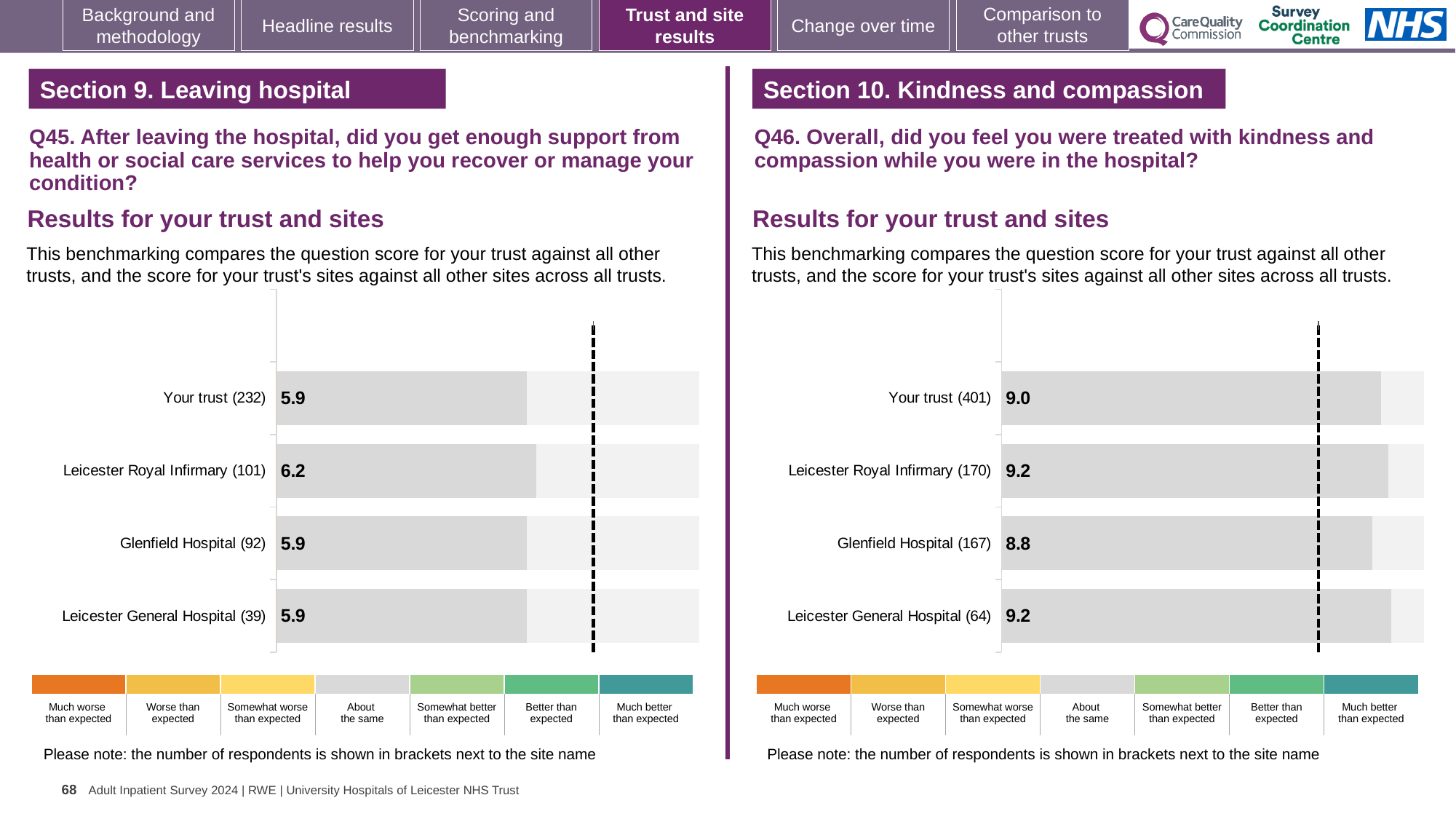
In the Q45 chart on the left, which site or trust has the highest score? Leicester Royal Infirmary In the Q46 chart on the right, how many respondents are shown in brackets for Your trust? 401 In the Q45 chart on the left, what is the score for Your trust? 5.9 In the Q46 chart on the right, what is the difference between the scores for Leicester Royal Infirmary and Glenfield Hospital? 0.4 In the Q46 chart on the right, what is the score for Glenfield Hospital? 8.8 In the Q46 chart on the right, what is the score for Leicester General Hospital? 9.2 In the Q45 chart on the left, what is the score for Leicester Royal Infirmary? 6.2 In the Q46 chart on the right, which has the higher score, Your trust or Leicester Royal Infirmary? Leicester Royal Infirmary In the Q46 chart on the right, which site or trust has the lowest score? Glenfield Hospital What kind of chart is used for the Q46 results on the right? Bar chart In the Q45 chart on the left, what is the difference between the scores for Leicester Royal Infirmary and Glenfield Hospital? 0.3 How many bars are plotted in the Q45 chart on the left? 4